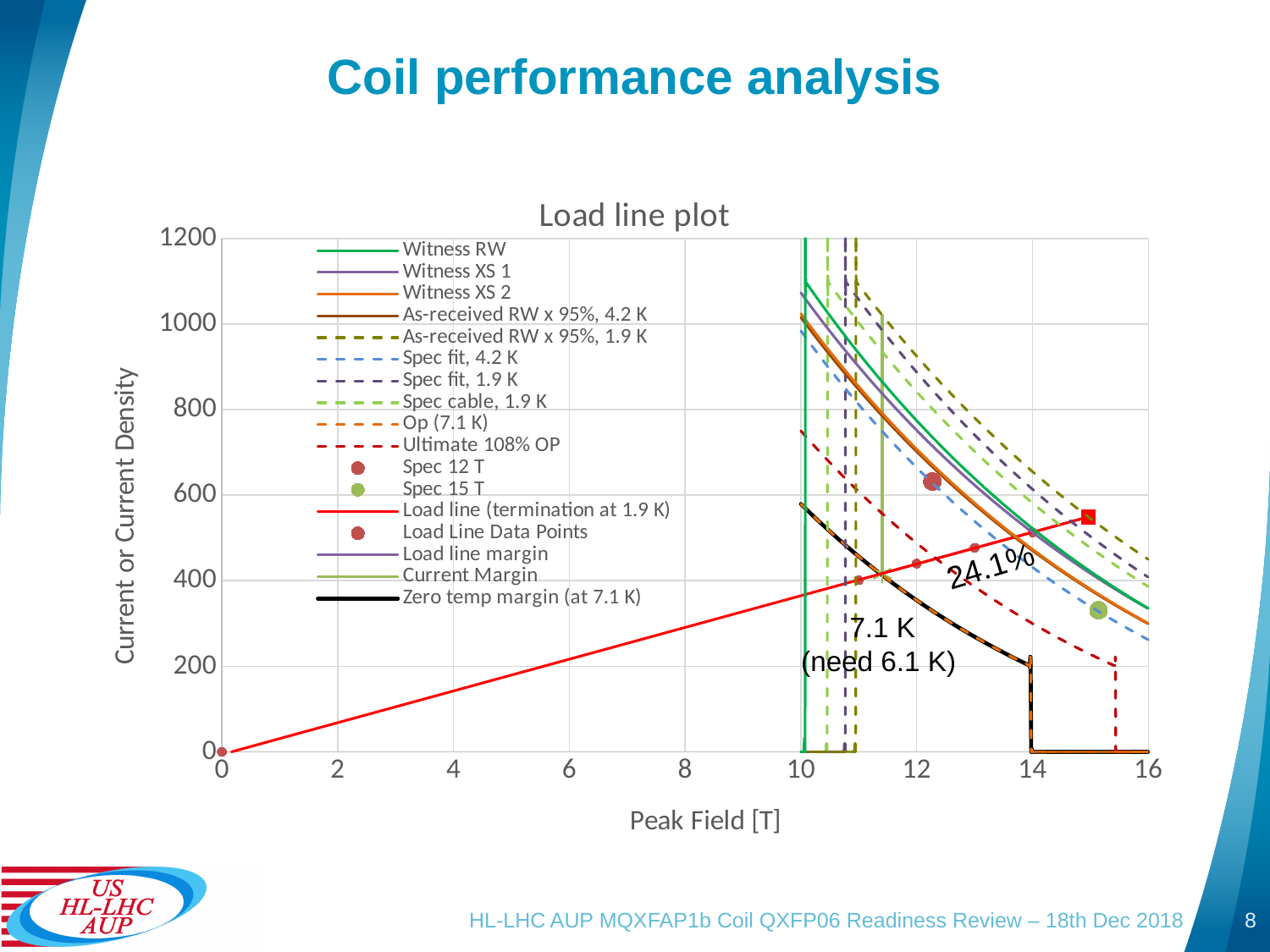
Which point has the larger value, Spec 12 T or Spec 15 T? Spec 12 T Does the Load line (termination at 1.9 K) rise or fall as Peak Field increases? rise What is the label of the x axis? Peak Field [T] Does the Witness RW curve rise or fall as Peak Field increases from 10 T to 16 T? fall Is the value of the Witness RW curve at 10 T greater or less than 1000? greater Is the value of the Load line at its end point near 15 T greater or less than 600? less What kind of chart is shown on the slide? line chart Is the value of the Spec 15 T point greater or less than 400? less How many series does the chart legend list? 17 What is the title of the chart? Load line plot What percentage margin is annotated next to the load line on the chart? 24.1%